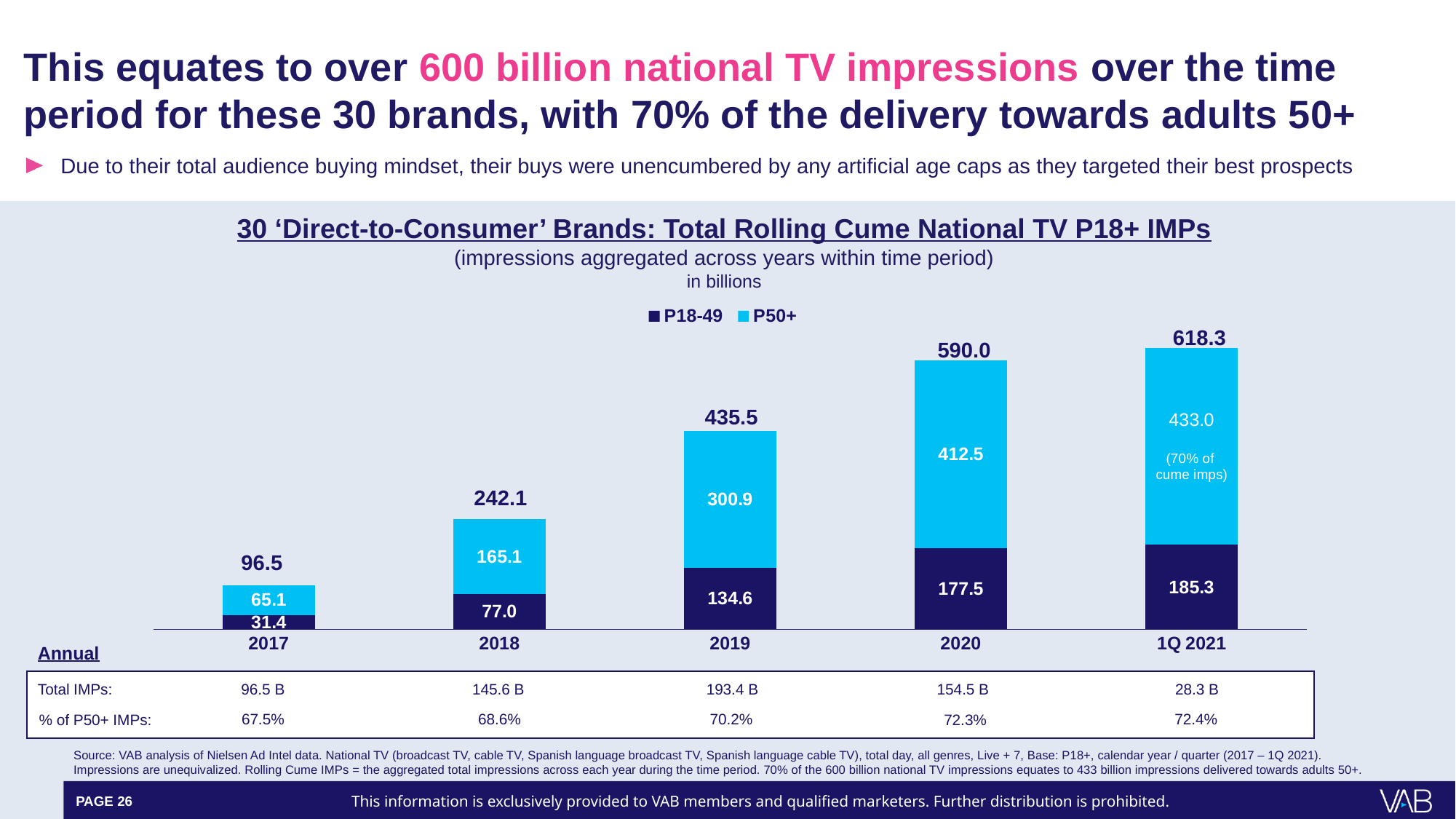
How many series does the legend list? 2 Which period has the lowest total rolling cume impressions? 2017 Do the total values rise or fall from 2017 to 1Q 2021? Rise Which period has the highest total rolling cume impressions? 1Q 2021 What is the P18-49 value for 2017? 31.4 What kind of chart is shown? Stacked bar chart What is the P50+ value for 2019? 300.9 What is the difference between the P50+ value and the P18-49 value for 2018? 88.1 Which is larger in 2020, the P18-49 value or the P50+ value? P50+ How many periods are shown on the x axis? 5 What is the total of the stacked bar for 2020? 590.0 What are the two series named in the legend? P18-49 and P50+